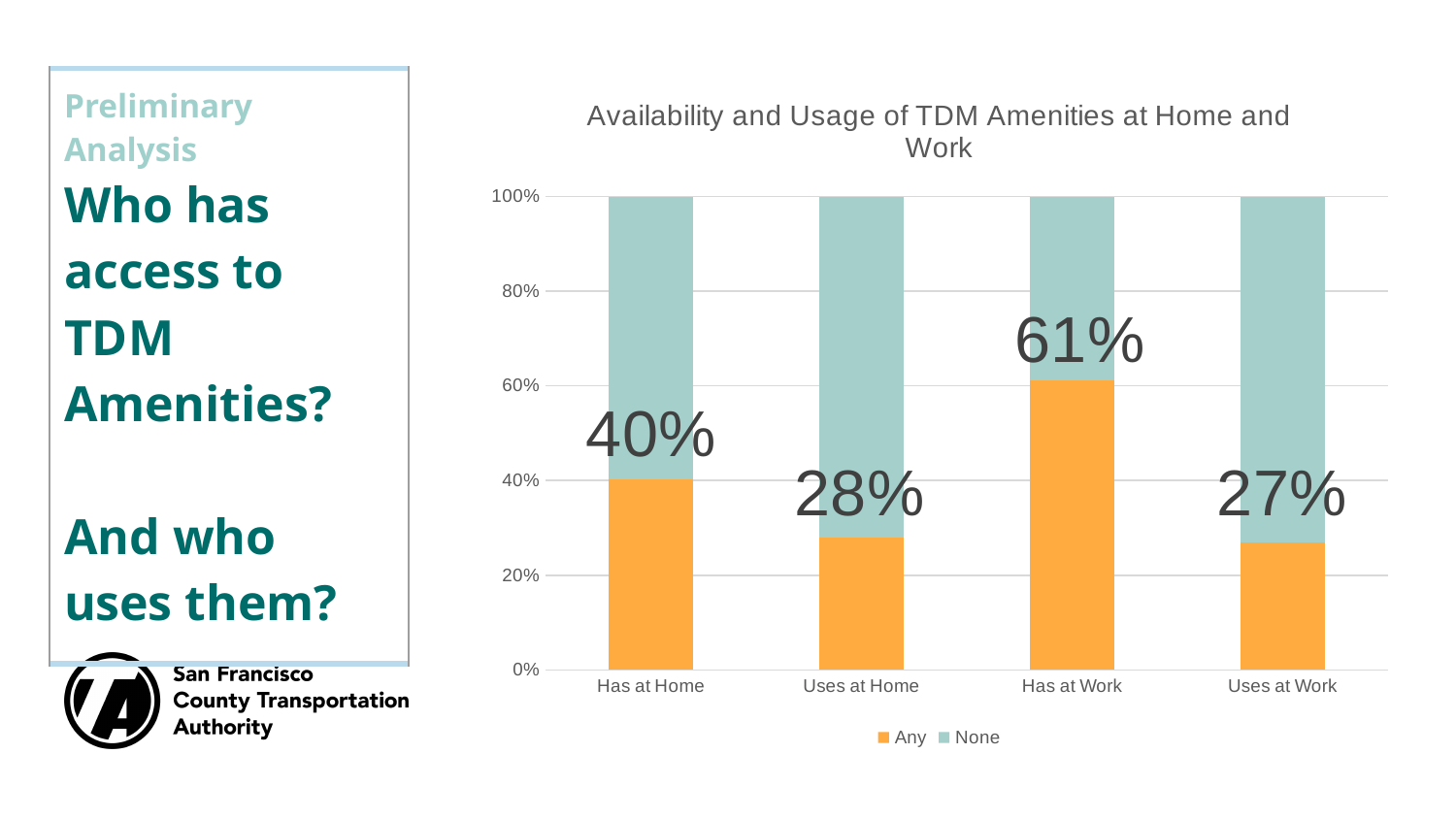
How many categories are shown on the x axis? 4 What is the value for "Any" in the Has at Home category? 40% Which category has the highest "Any" value? Has at Work What type of chart is shown on the slide? Stacked bar chart What is the difference between the "Any" values for Has at Home and Uses at Home? 12% What is the value for "Any" in the Uses at Work category? 27% How many series does the legend list? 2 What is the value for "Any" in the Has at Work category? 61% Is the "Any" value for Has at Work greater or less than 60%? greater Which is larger, the "Any" value for Has at Home or for Uses at Home? Has at Home What is the difference between the "Any" values for Has at Work and Has at Home? 21% Which category has the lowest "Any" value? Uses at Work